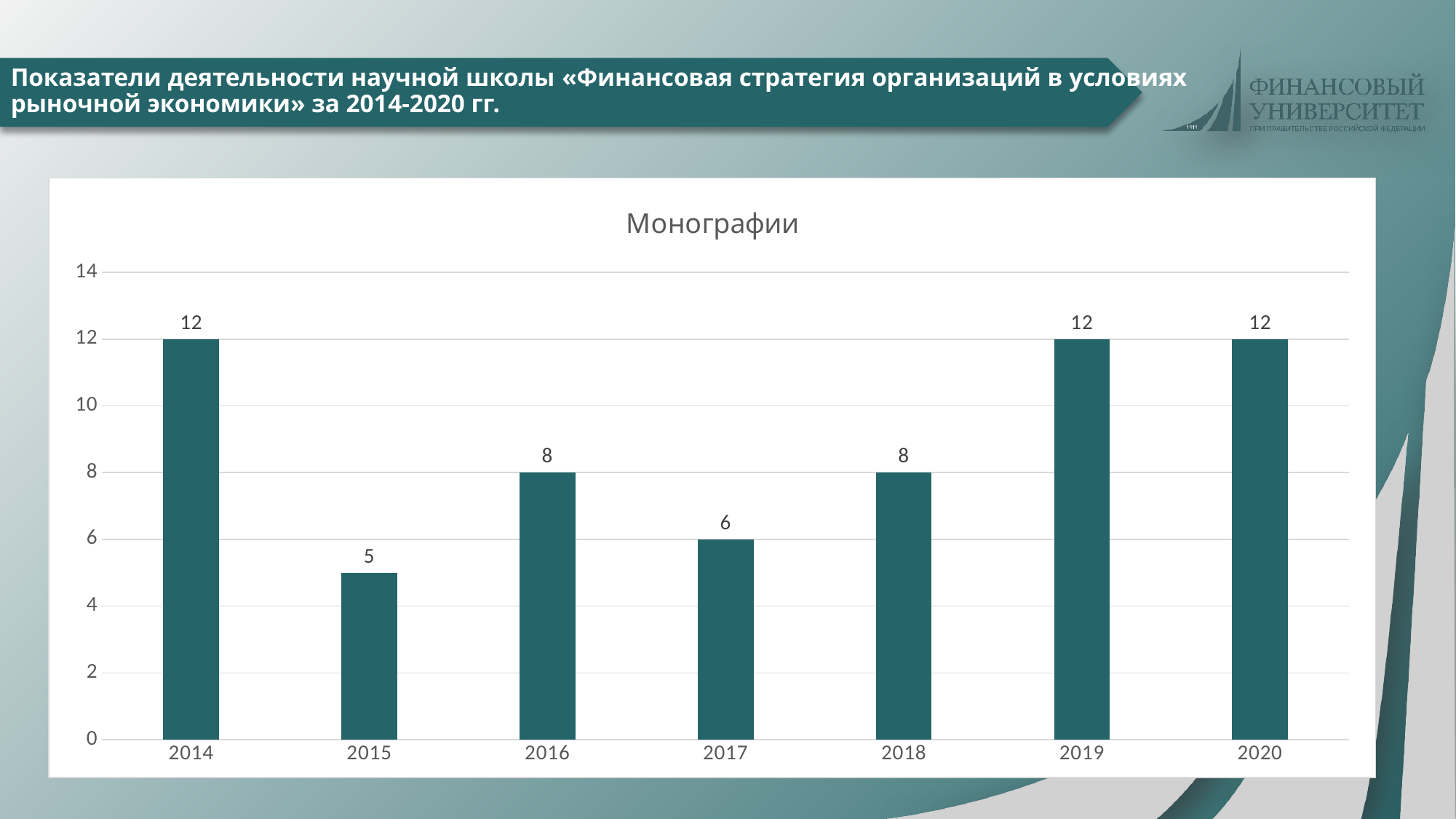
Is the value for 2020 greater or less than 10? greater What is the value for 2015? 5 What is the value for 2014? 12 What is the difference between the values for 2019 and 2017? 6 What is the difference between the values for 2016 and 2015? 3 What kind of chart is shown on the slide? bar chart Which year has the lowest value? 2015 How many years are shown on the x axis? 7 What is the value for 2017? 6 What is the title of the chart? Монографии Which is larger, the value for 2016 or the value for 2017? 2016 What is the value for 2018? 8